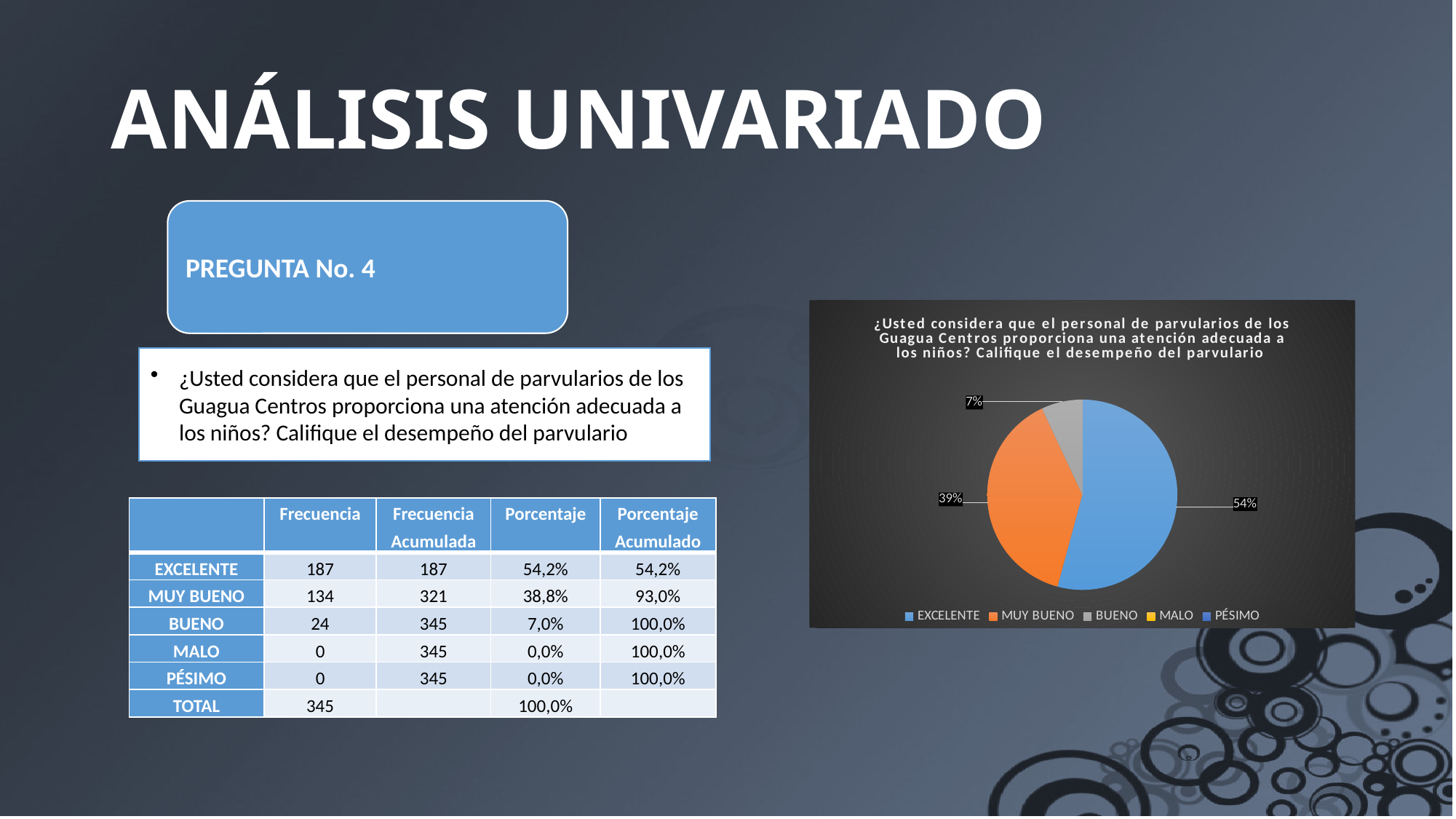
What percentage does the pie chart show for MUY BUENO? 39% How many entries does the legend of the pie chart list? 5 What percentage does the pie chart show for EXCELENTE? 54% Which of the labelled slices in the pie chart is the smallest? BUENO In the pie chart, which slice is larger, MUY BUENO or BUENO? MUY BUENO What percentage does the pie chart show for BUENO? 7% Which category has the largest slice in the pie chart? EXCELENTE What colour is the EXCELENTE slice in the pie chart? blue What is the difference in percentage points between the EXCELENTE and MUY BUENO slices in the pie chart? 15% What kind of chart is shown on the slide? pie chart What is the difference in percentage points between the MUY BUENO and BUENO slices in the pie chart? 32% How many slices with percentage labels are visible in the pie chart? 3